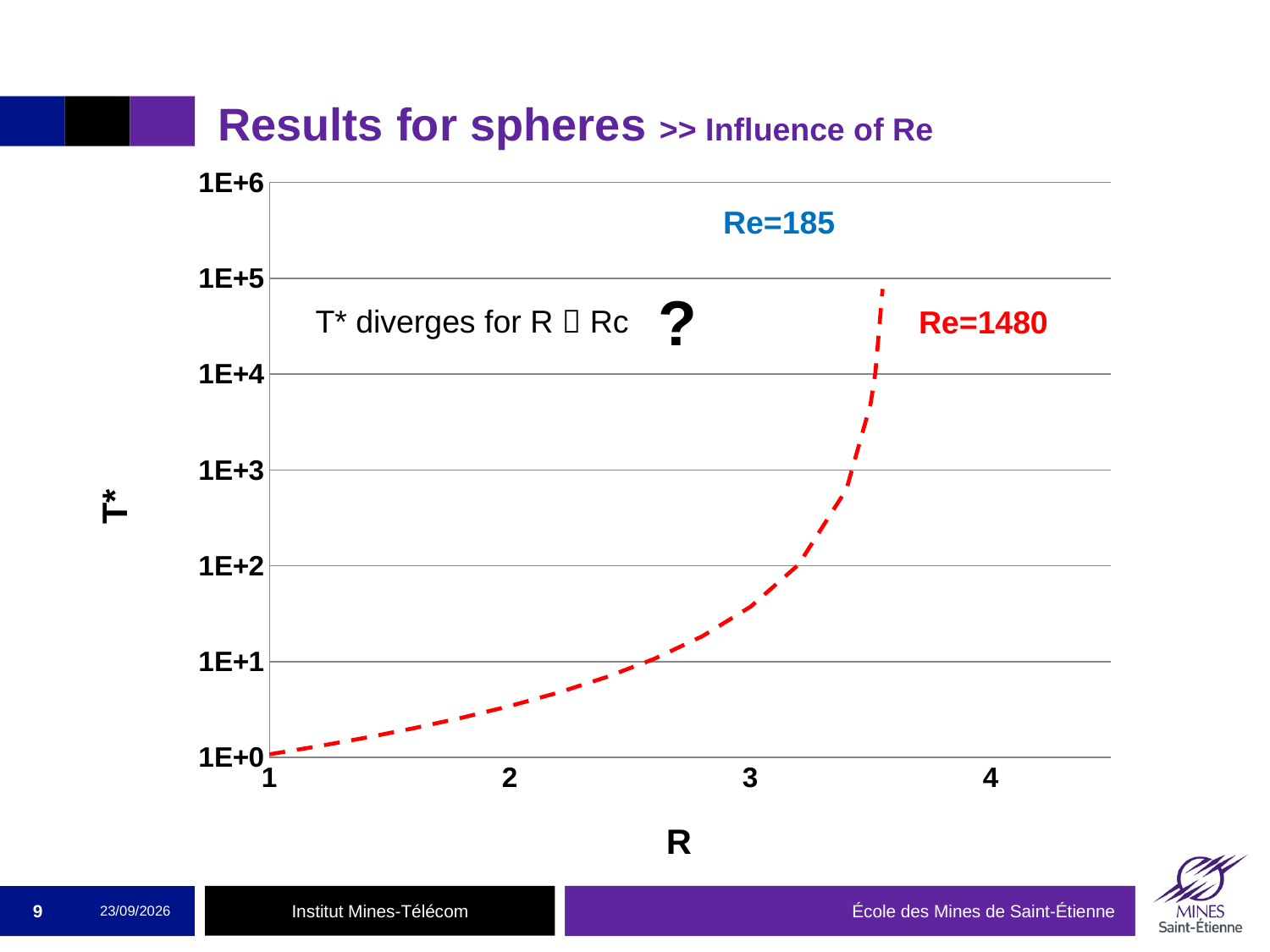
What is the highest tick value shown on the y axis? 1E+6 Does T* rise or fall as R increases along the x axis? rise What Reynolds number is written next to the red dashed curve? Re=1480 Is the value of T* at R=3 greater or less than 1E+4? less What is the label of the x axis? R What kind of chart is shown on the slide? line chart Is the value of T* at R=3 greater or less than 1E+1? greater Is the value of T* at R=2 greater or less than 1E+2? less What is the lowest tick value shown on the y axis? 1E+0 How many tick values are labelled on the x axis? 4 What is the label of the y axis? T*